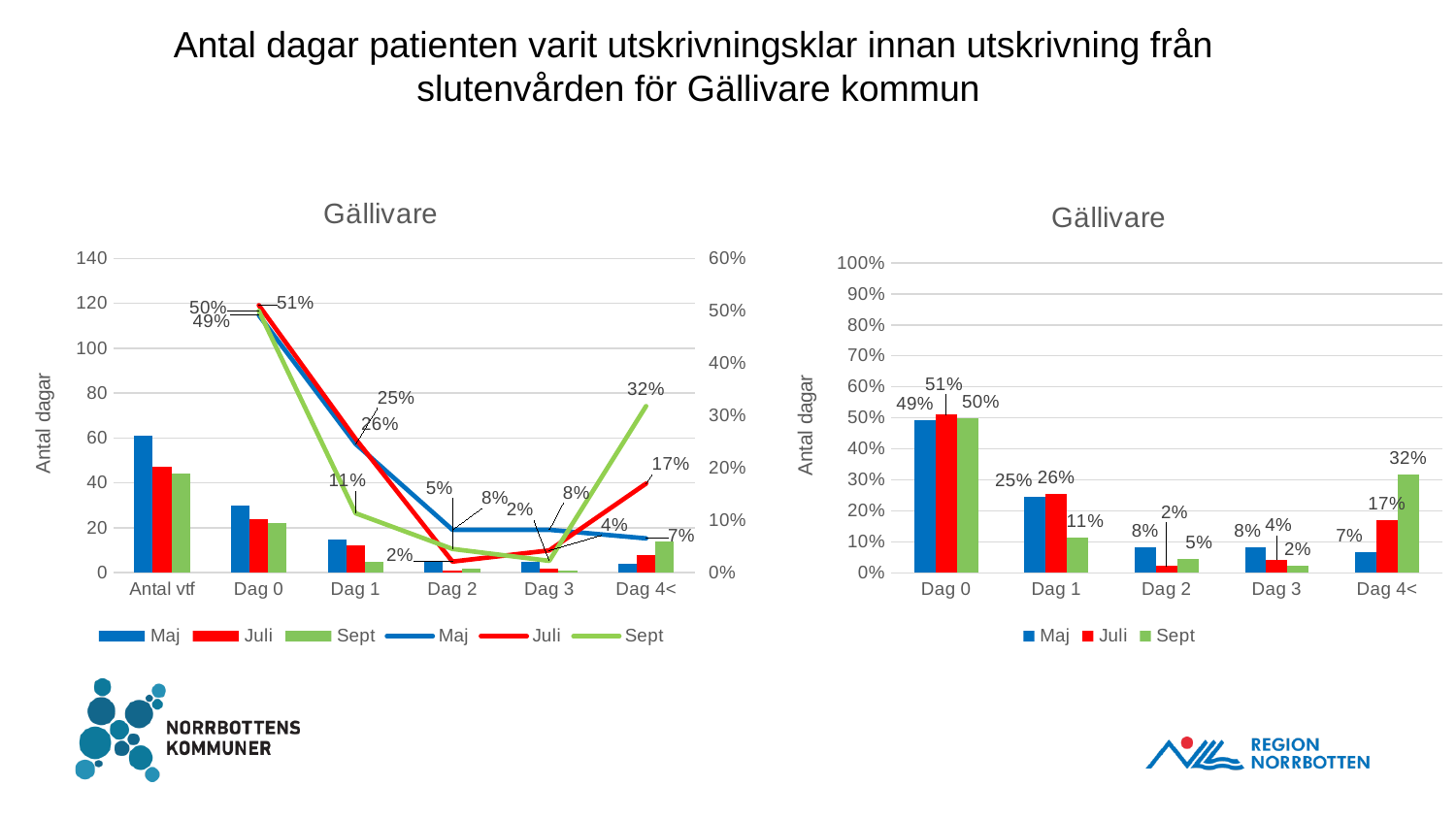
In the right-hand chart, what is the value for Sept at Dag 4<? 32% In the right-hand chart, what is the value for Juli at Dag 1? 26% What kind of chart is the right-hand chart? bar chart In the right-hand chart, which series has the lowest value at Dag 1? Sept In the right-hand chart, what is the value for Maj at Dag 0? 49% In the right-hand chart, which series has the highest value at Dag 4<? Sept In the right-hand chart, how many categories are shown on the x axis? 5 In the left-hand chart, is the Sept bar for Dag 0 greater or less than 40? less In the right-hand chart, which is larger at Dag 2: Maj or Sept? Maj In the right-hand chart, what is the difference between Sept and Maj at Dag 4<? 25% In the left-hand chart, is the Maj bar for Antal vtf greater or less than 40? greater In the right-hand chart, how many series does the legend list? 3